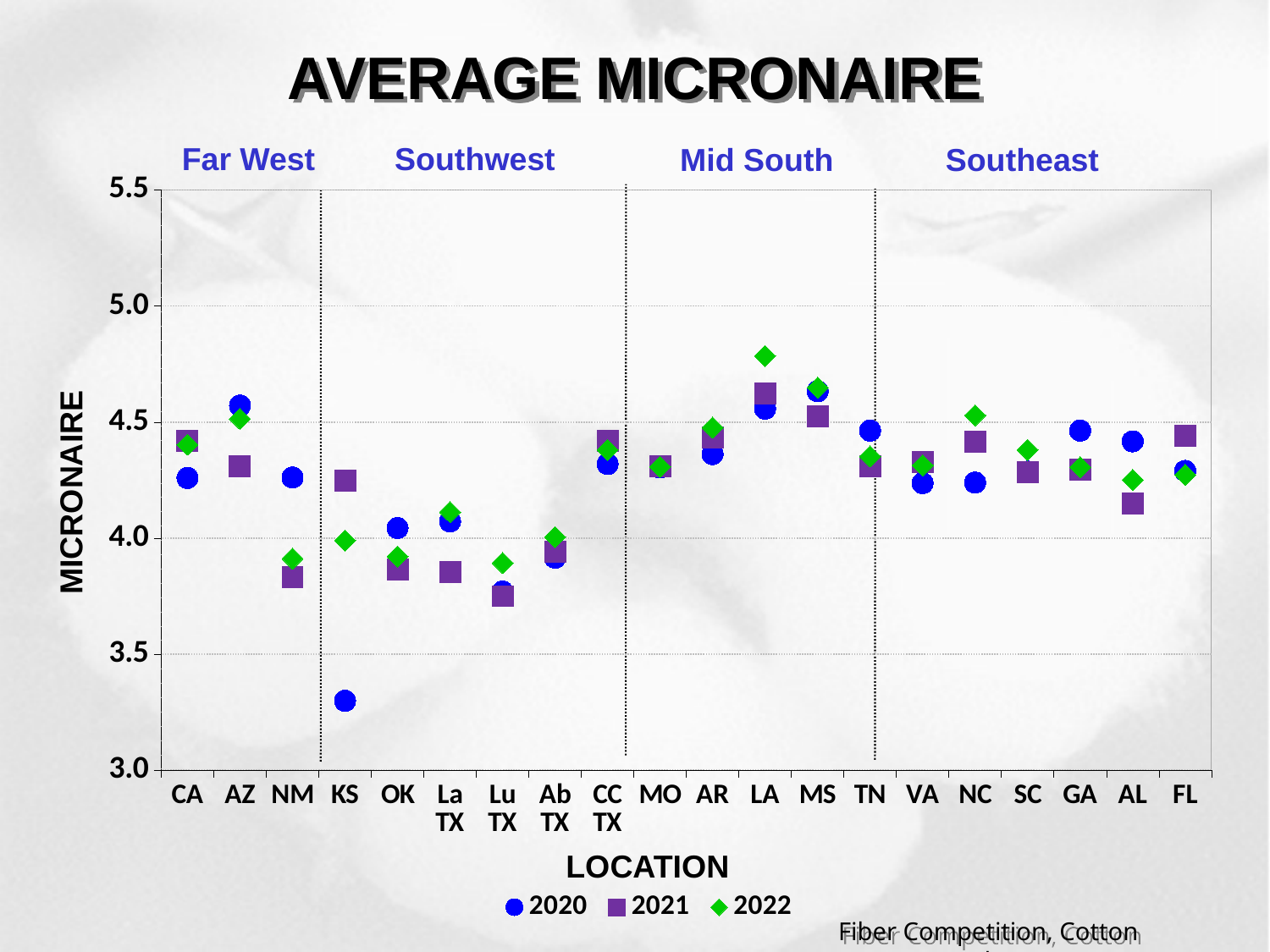
For KS, which is larger: the 2020 value or the 2021 value? 2021 What is the title of the chart? AVERAGE MICRONAIRE Is the 2022 value for LA greater or less than 4.5? greater Which location has the highest 2022 value? LA Is the 2020 value for KS greater or less than 3.5? less Is the 2021 value for Lu TX greater or less than 4.0? less How many locations are plotted along the x axis? 20 Which location has the lowest 2020 value? KS How many series does the legend list? 3 For AZ, which is larger: the 2020 value or the 2021 value? 2020 What kind of chart is shown on the slide? scatter chart